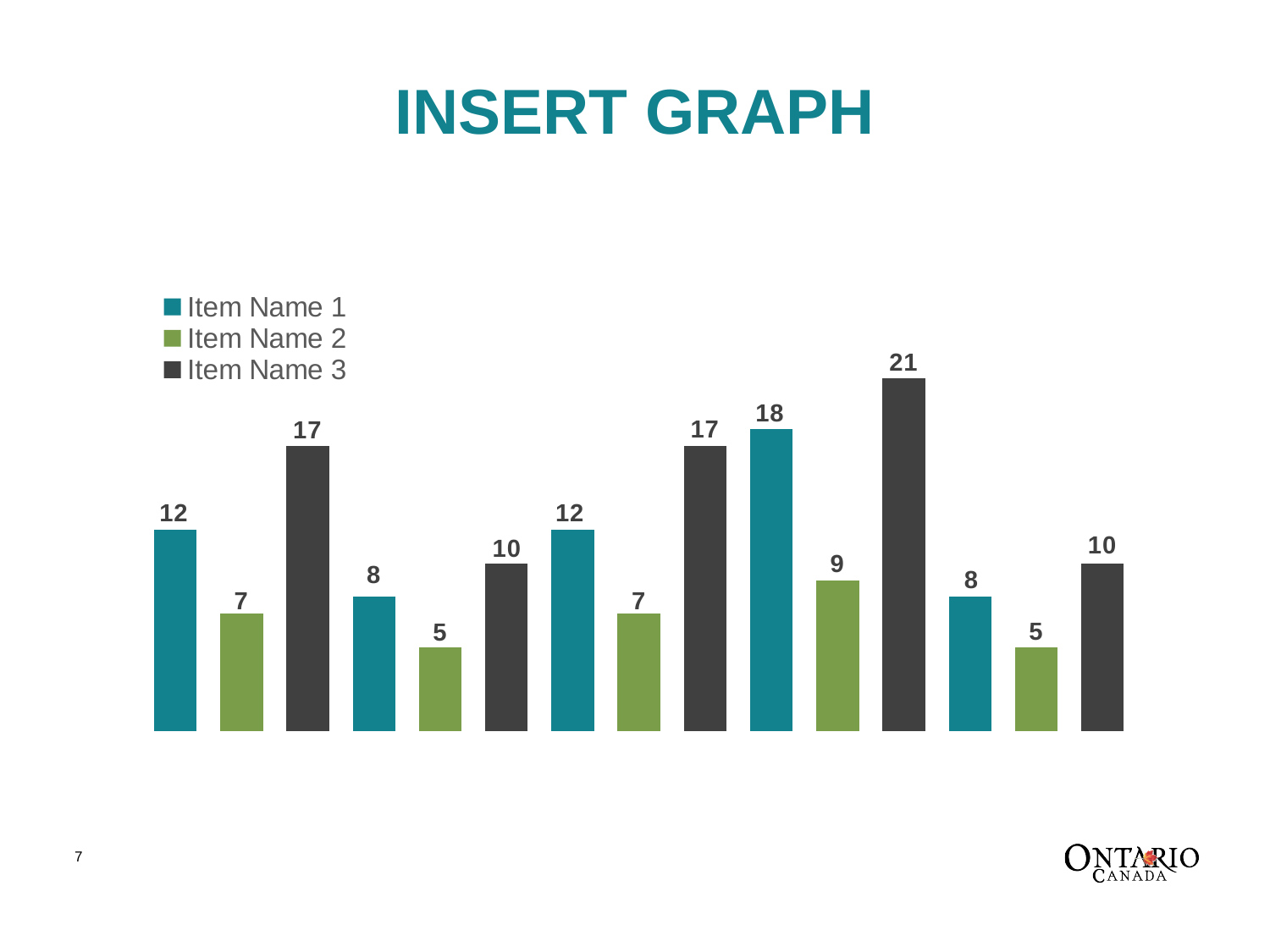
How many groups of bars are plotted in the chart? 5 What is the highest value shown in the chart? 21 What is the lowest value shown in the chart? 5 How many series does the legend list? 3 What is the title of the slide containing the chart? INSERT GRAPH In the first group of bars, which series has the larger value, Item Name 1 or Item Name 2? Item Name 1 Which series has the tallest bar in the fourth group of bars? Item Name 3 What is the value of the Item Name 1 bar in the fourth group of bars? 18 What is the difference between the Item Name 3 bar and the Item Name 1 bar in the fourth group of bars? 3 What is the value of the Item Name 3 bar in the second group of bars? 10 What kind of chart is shown on the slide? bar chart What is the value of the Item Name 2 bar in the first group of bars? 7